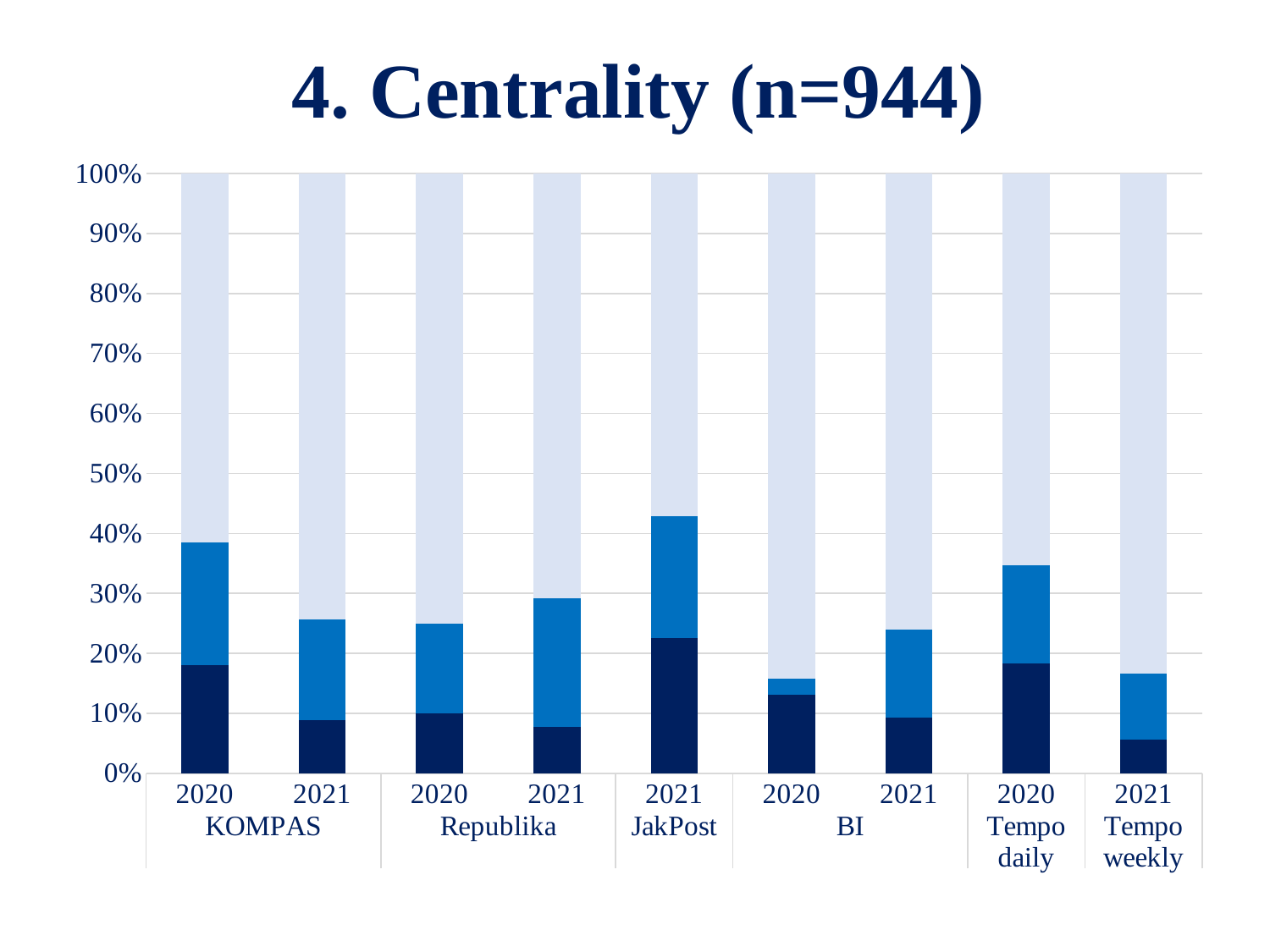
For BI, is the combined dark navy and medium blue portion larger in 2020 or 2021? 2021 What is the total height of each stacked bar on the percentage axis? 100% Is the combined dark navy and medium blue portion for JakPost 2021 greater or less than 40%? greater Which bar has the highest combined dark navy and medium blue portion? JakPost 2021 What is the title of the chart? 4. Centrality (n=944) Which bar has the tallest dark navy bottom segment? JakPost 2021 Is the dark navy bottom segment for Tempo weekly 2021 greater or less than 10%? less How many bars are plotted in the chart? 9 Which bar has the shortest dark navy bottom segment? Tempo weekly 2021 What kind of chart is shown on the slide? stacked bar chart Is the combined dark navy and medium blue portion for BI 2020 greater or less than 20%? less For KOMPAS, is the combined dark navy and medium blue portion larger in 2020 or 2021? 2020